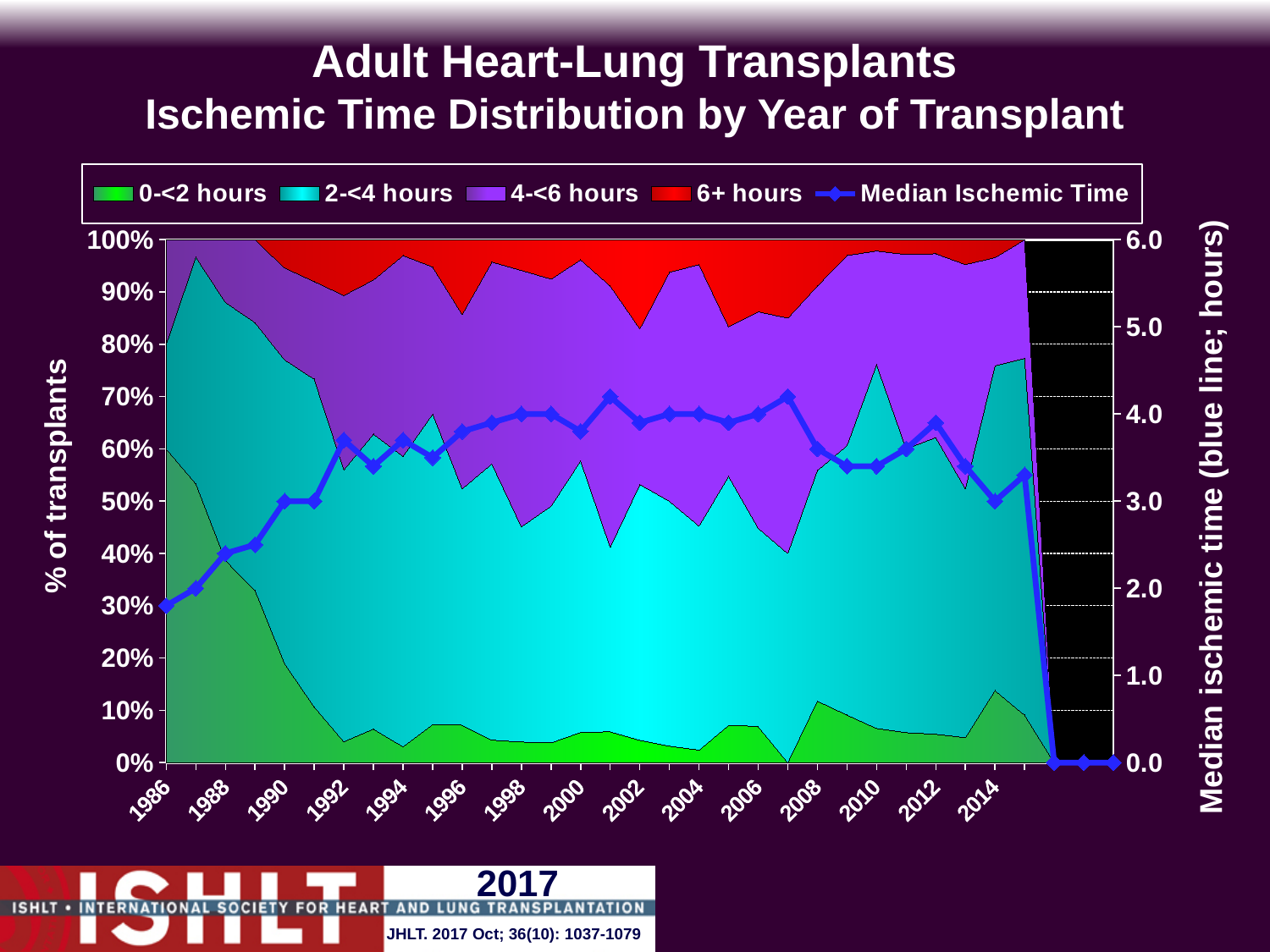
Is the median ischemic time in 2013 greater or less than 4.0 hours? less How many series does the legend list? 5 Which series is plotted as the blue line with diamond markers? Median Ischemic Time Is the share of transplants with 0-<2 hours ischemic time in 1986 greater or less than 50%? greater How many year labels are shown on the x axis? 15 Is the median ischemic time in 1992 greater or less than 3.0 hours? greater What is the title of the chart? Adult Heart-Lung Transplants Ischemic Time Distribution by Year of Transplant What kind of chart is shown on the slide? Stacked area chart with a line Does the median ischemic time rise or fall from 1986 to 1992? rise